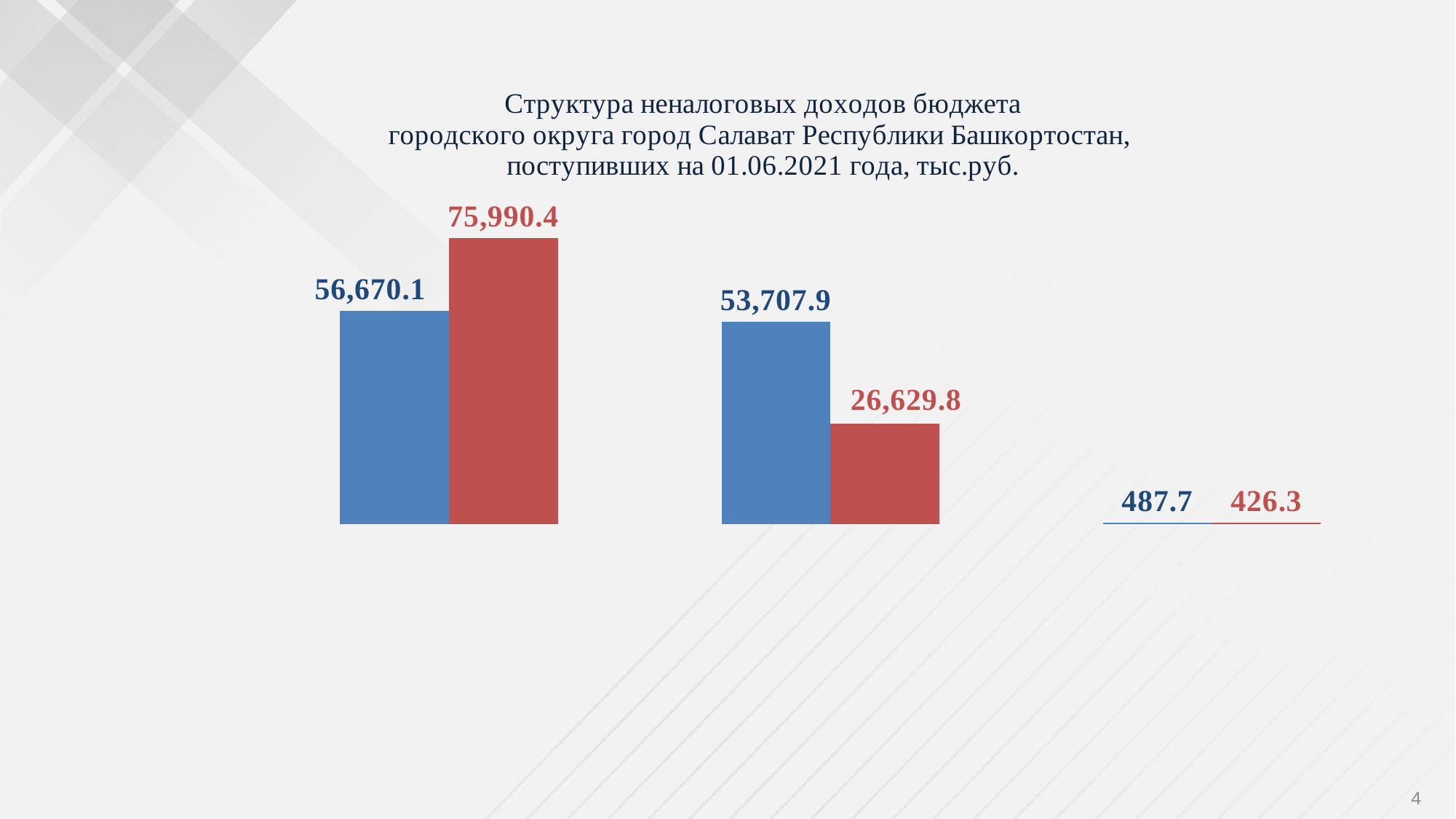
Which bar has the lowest value on the chart? the red bar in the rightmost group (426.3) What is the difference between the red and blue bars in the leftmost group? 19,320.3 What is the value of the red bar in the leftmost group? 75,990.4 How many groups of bars are shown on the chart? 3 What is the value of the red bar in the middle group? 26,629.8 Which bar has the highest value on the chart? the red bar in the leftmost group (75,990.4) What is the value of the blue bar in the rightmost group? 487.7 What is the value of the red bar in the rightmost group? 426.3 In the middle group, which bar is larger, the blue one or the red one? the blue one What is the value of the blue bar in the middle group? 53,707.9 What kind of chart is shown on the slide? bar chart What is the value of the blue bar in the leftmost group? 56,670.1